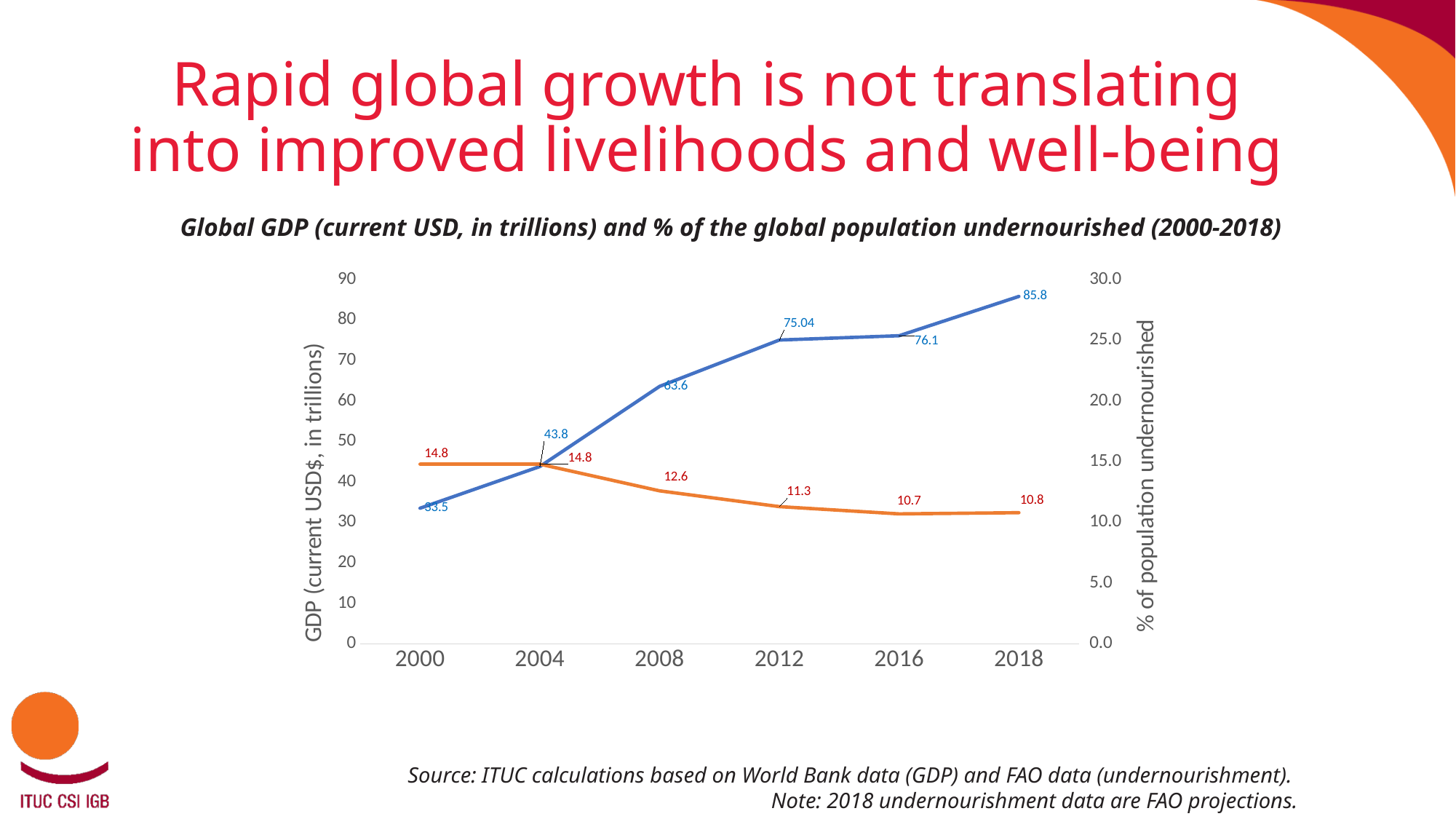
What percentage of the global population was undernourished in 2012? 11.3 What is the global GDP value (current USD, in trillions) for 2000? 33.5 What is the title of the chart? Global GDP (current USD, in trillions) and % of the global population undernourished (2000-2018) What type of chart is shown on the slide? Line chart In which year is the global GDP value highest? 2018 What percentage of the global population was undernourished in 2008? 12.6 Does the percentage of the global population undernourished generally rise or fall from 2000 to 2018? Fall What is the global GDP value (current USD, in trillions) for 2018? 85.8 In which year is the percentage of the global population undernourished lowest? 2016 How many years are plotted on the x axis? 6 Which is larger: the global GDP value for 2008 or for 2004? 2008 What is the difference between the global GDP values for 2018 and 2000? 52.3